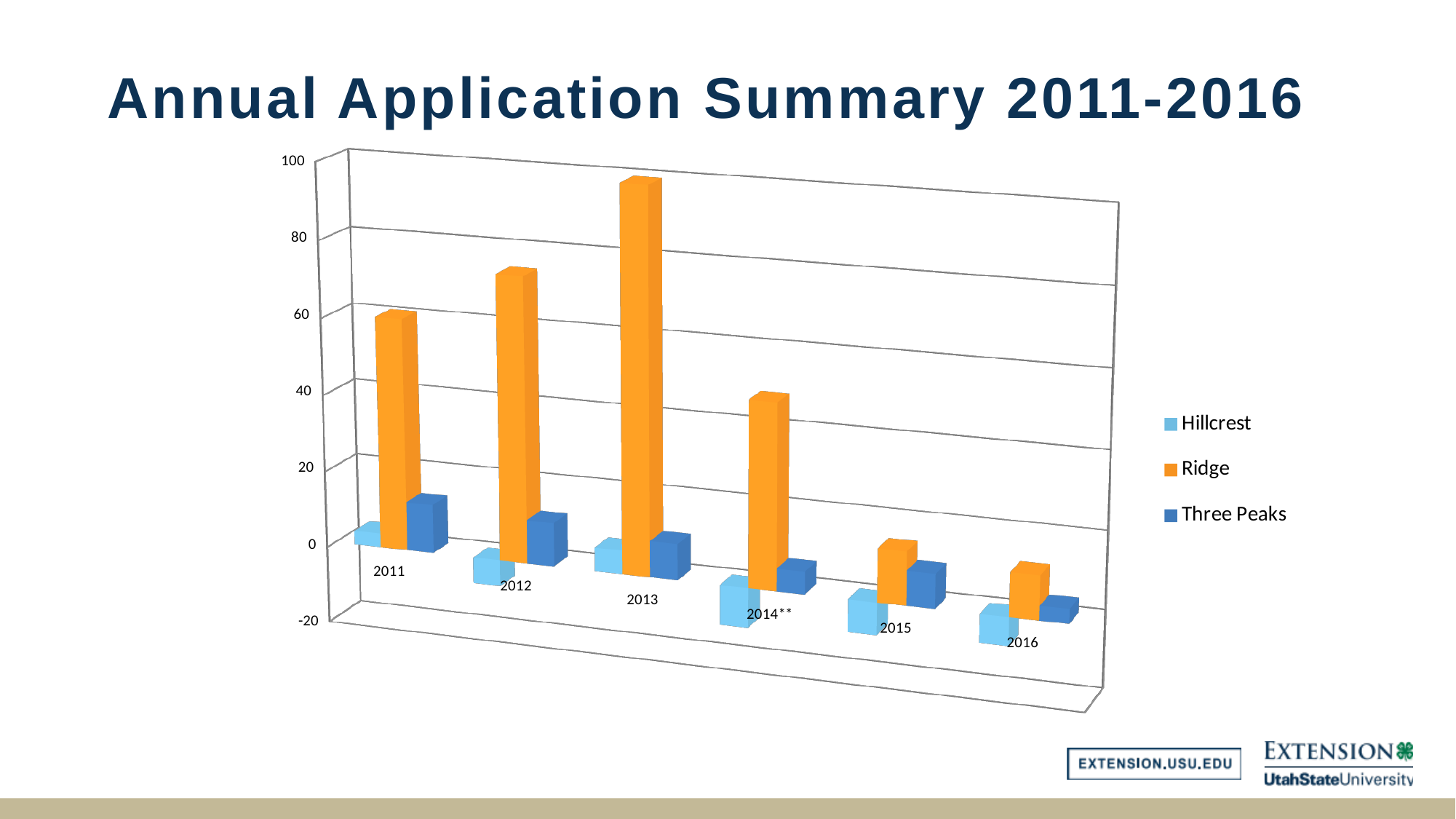
How many years (categories) are shown on the x axis? 6 Is the Ridge value for 2013 greater or less than 80? greater Is the Ridge value for 2012 greater or less than 60? greater In which year is the Ridge value highest? 2013 What kind of chart is shown on the slide? bar chart How many series does the legend list? 3 Do the Ridge values rise or fall from 2013 to 2016? fall What is the title of the chart slide? Annual Application Summary 2011-2016 Which series is shown in orange? Ridge Is the Ridge value for 2011 greater or less than 40? greater Which is larger, the Ridge value for 2013 or the Ridge value for 2014**? 2013